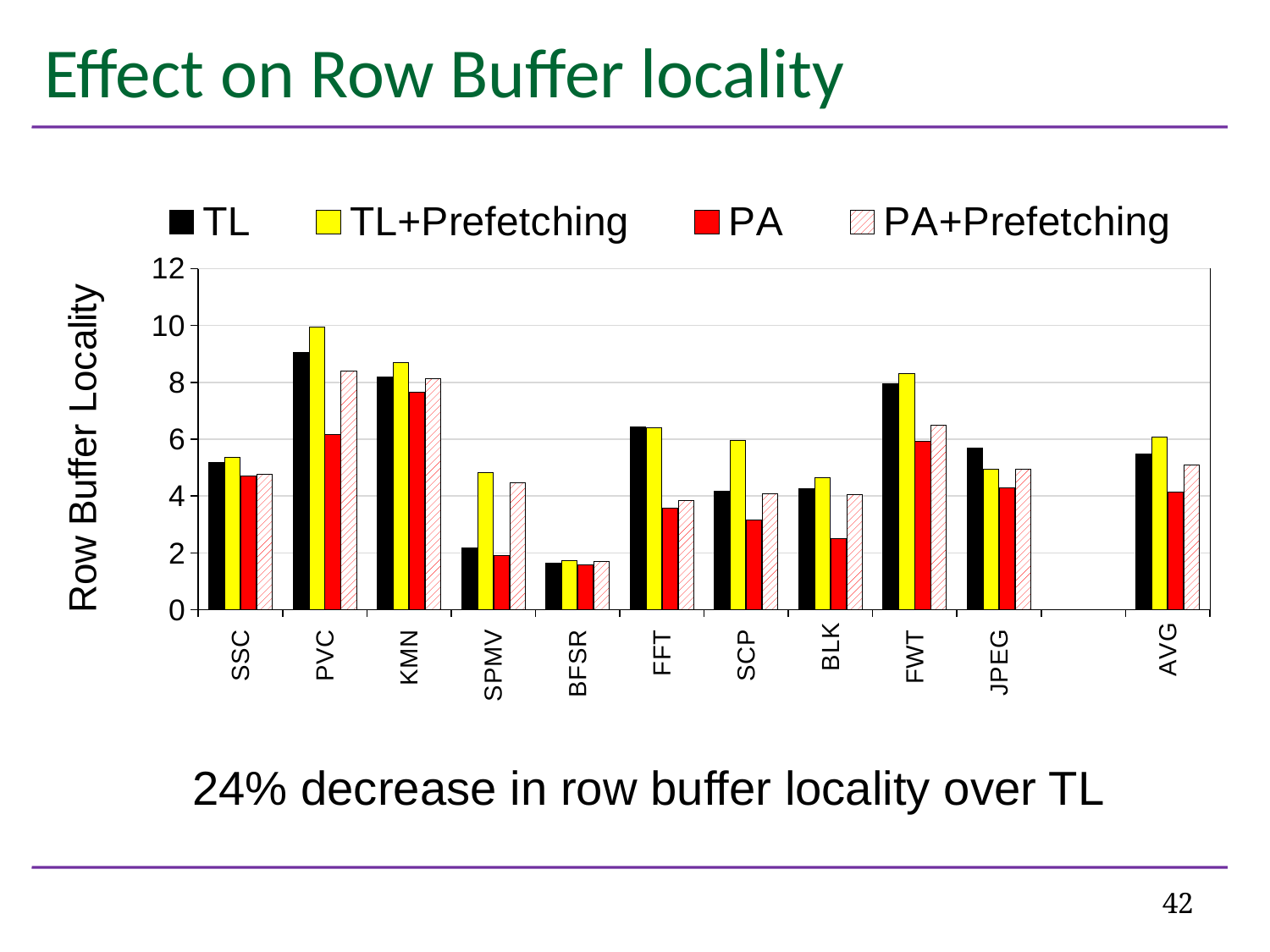
Is the TL value for SPMV greater or less than 4? less Which category has the lowest TL value? BFSR Which is larger, the TL value for PVC or the TL value for KMN? PVC Which category has the highest TL+Prefetching value? PVC How many categories are shown on the x axis? 11 What is the label of the y axis? Row Buffer Locality Is the TL+Prefetching value for PVC greater or less than 8? greater How many series does the legend list? 4 What kind of chart is shown on the slide? bar chart Which is larger for SCP, the TL+Prefetching value or the PA value? TL+Prefetching Is the PA value for AVG greater or less than 6? less Which category has the highest TL value? PVC